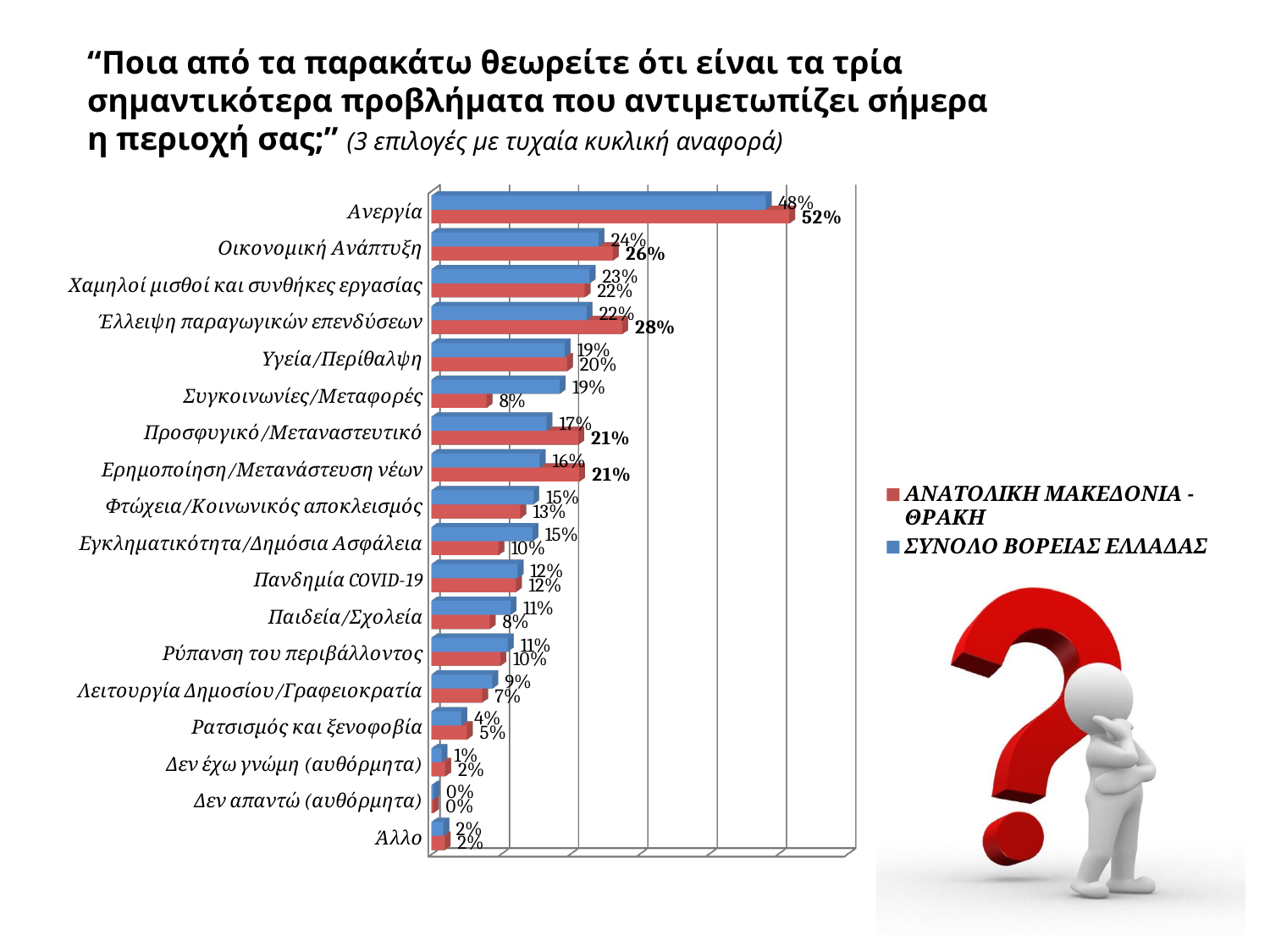
Which category has the lowest value in the ΣΥΝΟΛΟ ΒΟΡΕΙΑΣ ΕΛΛΑΔΑΣ series? Δεν απαντώ (αυθόρμητα) Which category has the highest value in the ΑΝΑΤΟΛΙΚΗ ΜΑΚΕΔΟΝΙΑ - ΘΡΑΚΗ series? Ανεργία For Εγκληματικότητα/Δημόσια Ασφάλεια, which series has the larger value? ΣΥΝΟΛΟ ΒΟΡΕΙΑΣ ΕΛΛΑΔΑΣ What kind of chart is shown on the slide? Bar chart What is the value for Έλλειψη παραγωγικών επενδύσεων in the ΑΝΑΤΟΛΙΚΗ ΜΑΚΕΔΟΝΙΑ - ΘΡΑΚΗ series? 28% What is the difference between the ΑΝΑΤΟΛΙΚΗ ΜΑΚΕΔΟΝΙΑ - ΘΡΑΚΗ and ΣΥΝΟΛΟ ΒΟΡΕΙΑΣ ΕΛΛΑΔΑΣ values for Έλλειψη παραγωγικών επενδύσεων? 6% What is the value for Ανεργία in the ΑΝΑΤΟΛΙΚΗ ΜΑΚΕΔΟΝΙΑ - ΘΡΑΚΗ series? 52% How many series does the legend list? 2 How many categories are shown on the chart? 18 What is the value for Ανεργία in the ΣΥΝΟΛΟ ΒΟΡΕΙΑΣ ΕΛΛΑΔΑΣ series? 48% What is the value for Συγκοινωνίες/Μεταφορές in the ΣΥΝΟΛΟ ΒΟΡΕΙΑΣ ΕΛΛΑΔΑΣ series? 19% What is the difference between the ΑΝΑΤΟΛΙΚΗ ΜΑΚΕΔΟΝΙΑ - ΘΡΑΚΗ and ΣΥΝΟΛΟ ΒΟΡΕΙΑΣ ΕΛΛΑΔΑΣ values for Συγκοινωνίες/Μεταφορές? 11%